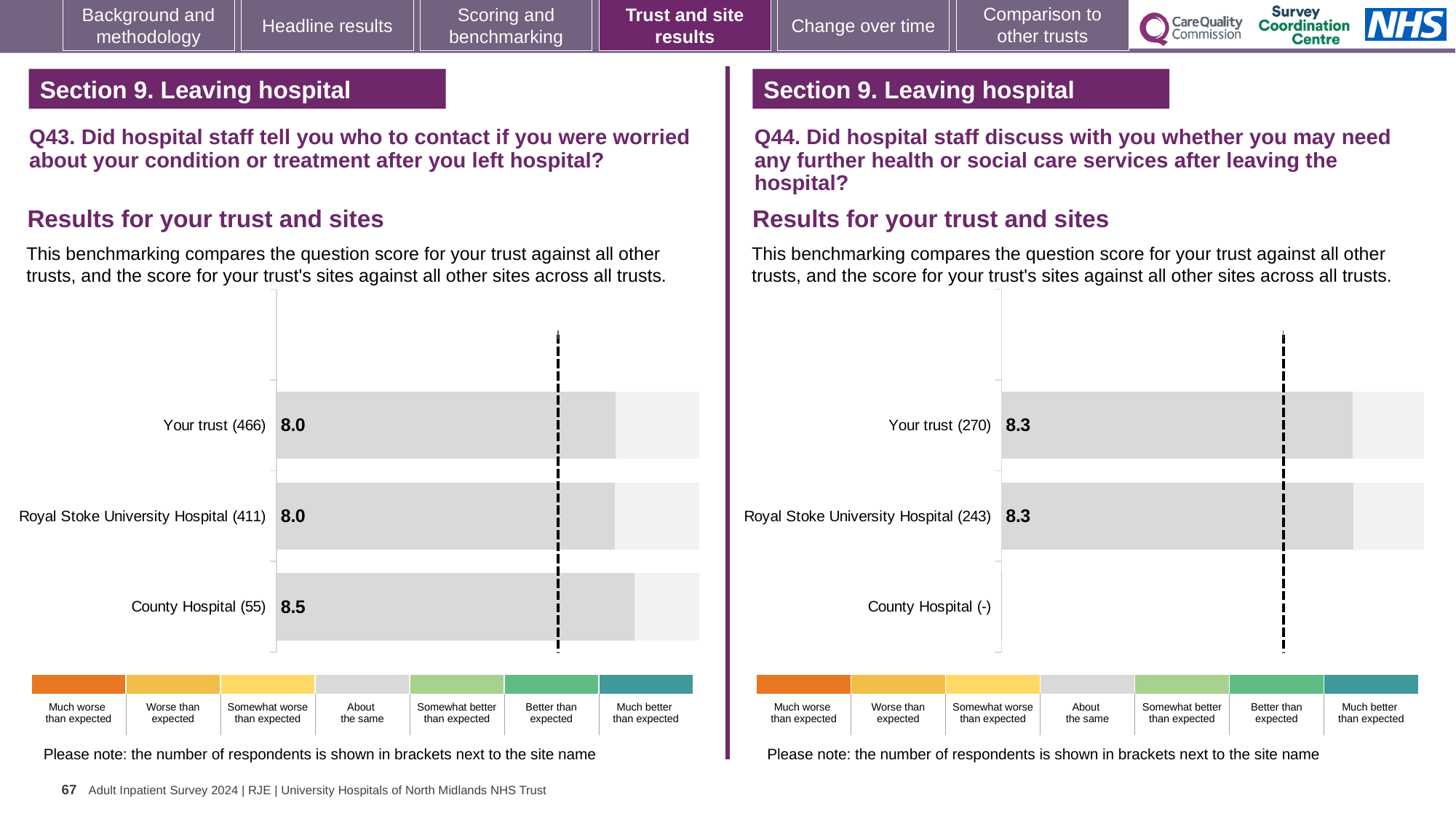
In the Q43 chart on the left, what is the score for Your trust? 8.0 In the Q43 chart on the left, what is the score for County Hospital? 8.5 How many respondents are shown in brackets for Your trust in the Q44 chart on the right? 270 In the Q43 chart on the left, is the score for County Hospital larger or smaller than the score for Royal Stoke University Hospital? larger In the Q43 chart on the left, what is the score for Royal Stoke University Hospital? 8.0 In the Q43 chart on the left, what is the difference between the County Hospital score and the Your trust score? 0.5 In the Q44 chart on the right, what is the score for Your trust? 8.3 In the Q43 chart on the left, which site or trust has the highest score? County Hospital In the Q44 chart on the right, what is the score for Royal Stoke University Hospital? 8.3 How many categories are listed on the vertical axis of the Q43 chart on the left? 3 How many bars with a printed score are shown in the Q44 chart on the right? 2 What kind of chart is used in the Q43 chart on the left? bar chart